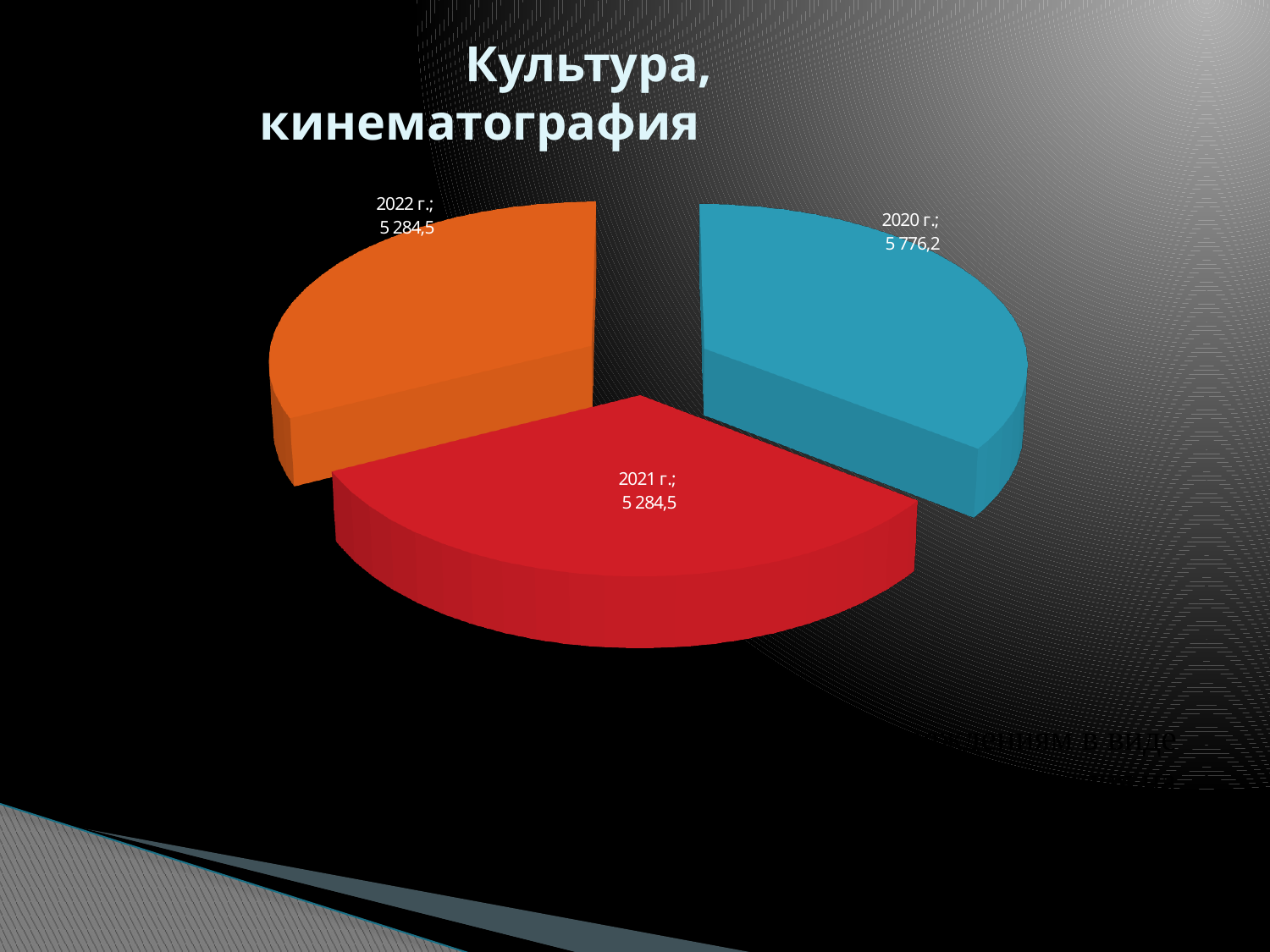
Which year has the largest slice in the pie chart? 2020 г. What is the difference between the values for 2020 г. and 2021 г.? 491,7 What is the title of the chart on the slide? Культура, кинематография Which is larger, the value for 2020 г. or the value for 2022 г.? 2020 г. What is the value for 2020 г. in the pie chart? 5 776,2 How many slices does the pie chart have? 3 What colour is the slice for 2020 г.? blue What kind of chart is shown on the slide? pie chart What is the value for 2022 г. in the pie chart? 5 284,5 What is the total of all three slices in the pie chart? 16 345,2 What is the value for 2021 г. in the pie chart? 5 284,5 What share of the pie does the 2020 г. slice represent, to one decimal place? 35,3%